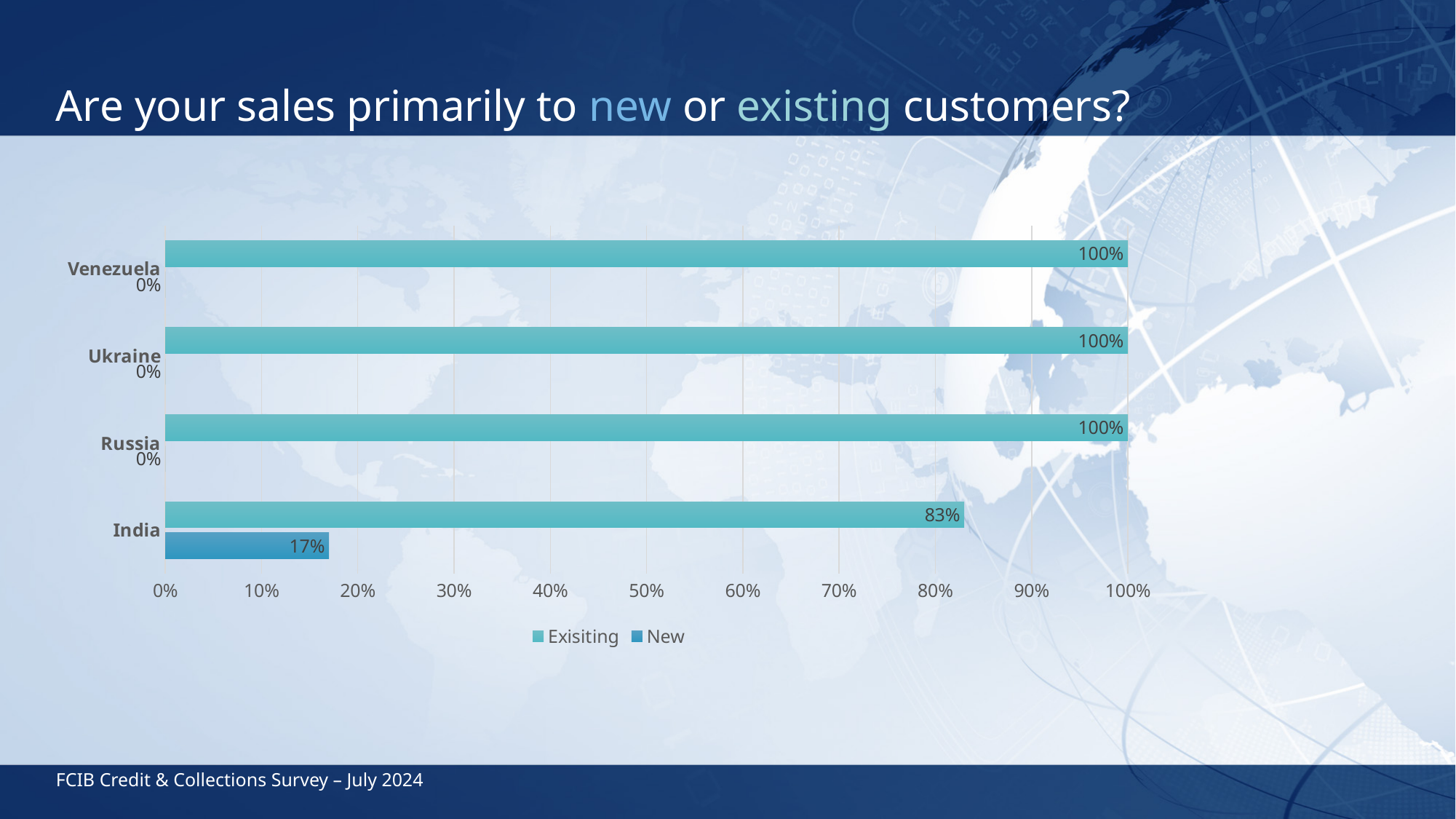
What is the Exisiting value for India? 83% What is the New value for Ukraine? 0% How many series does the legend list? 2 Which country has the highest New value? India What kind of chart is shown on the slide? Bar chart How many countries are shown on the chart? 4 Which is larger for India, the Exisiting value or the New value? Exisiting Which country has the lowest Exisiting value? India What is the difference between the Exisiting and New values for India? 66% What is the New value for India? 17% What are the two series named in the legend? Exisiting and New What is the Exisiting value for Russia? 100%